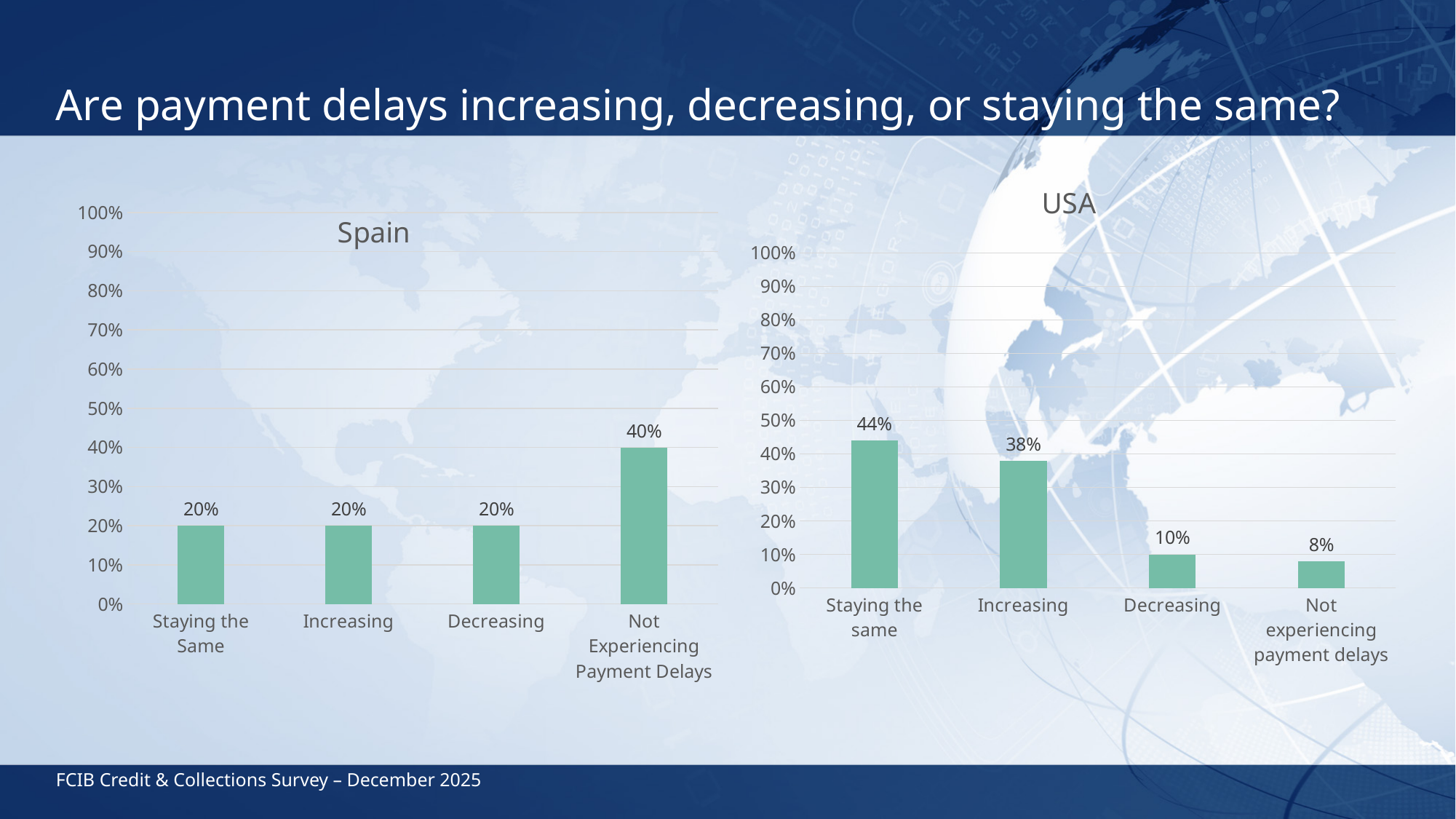
In the Spain chart, which category has the highest value? Not Experiencing Payment Delays In the USA chart, which category has the highest value? Staying the same In the Spain chart, what is the value for Not Experiencing Payment Delays? 40% How many categories are shown in the USA chart? 4 In the USA chart, what is the value for Decreasing? 10% What type of chart is the Spain chart? Bar chart In the USA chart, what is the value for Staying the same? 44% In the Spain chart, what is the value for Increasing? 20% Which is larger: the Increasing value in the USA chart or the Increasing value in the Spain chart? USA In the Spain chart, what is the difference between Not Experiencing Payment Delays and Decreasing? 20% In the USA chart, what is the difference between Staying the same and Increasing? 6% In the USA chart, which category has the lowest value? Not experiencing payment delays